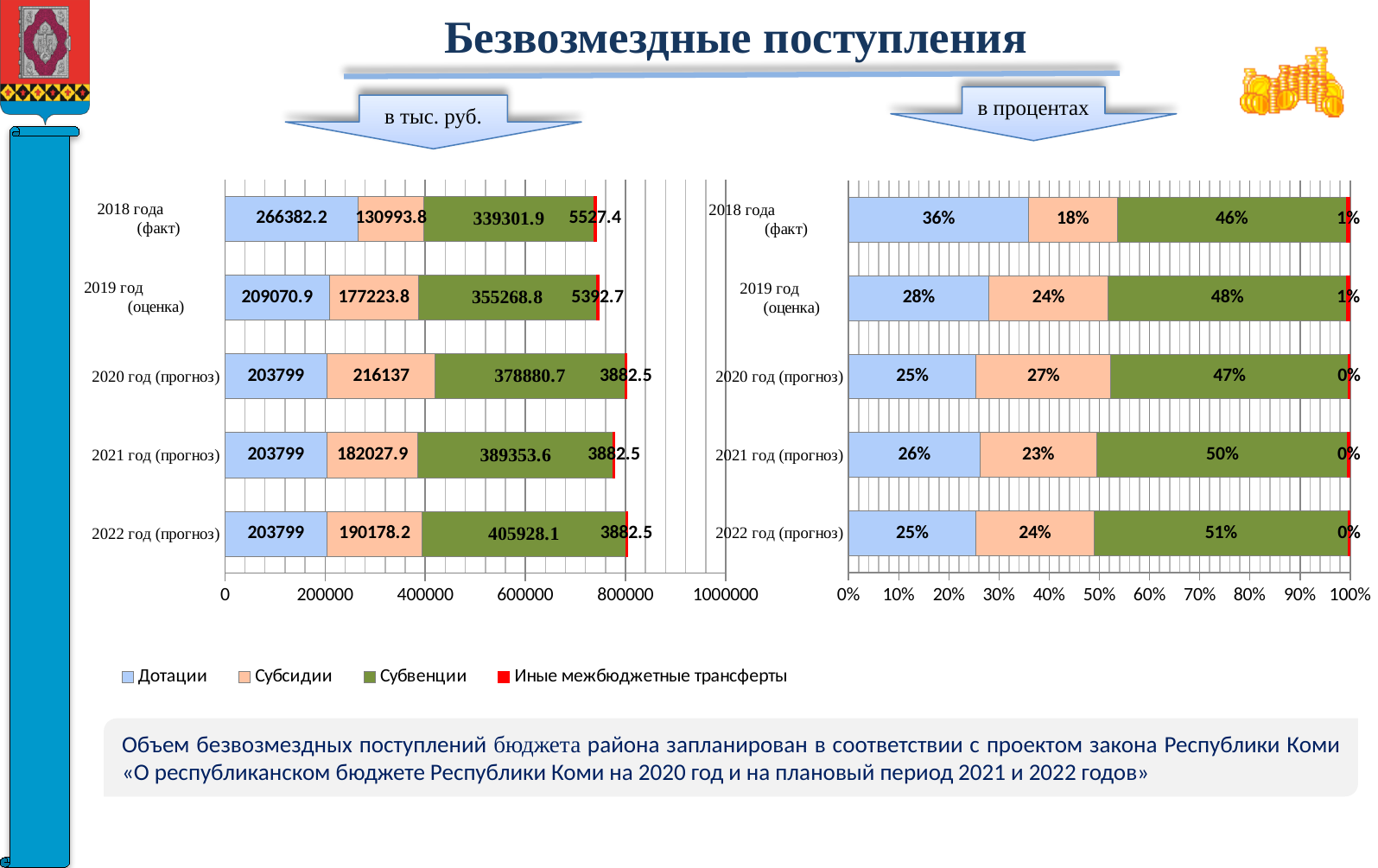
What kind of chart is the right chart (в процентах)? Stacked bar chart In the left chart (в тыс. руб.), what is the value of Субвенции for 2022 год (прогноз)? 405928.1 In the left chart (в тыс. руб.), is the total length of the 2018 года (факт) bar greater or less than 800000? less How many series does the legend list? 4 In the left chart (в тыс. руб.), do the values for Субвенции rise or fall from 2018 года (факт) to 2022 год (прогноз)? rise In the right chart (в процентах), what share do Дотации make up in 2018 года (факт)? 36% How many year categories are shown in the left chart (в тыс. руб.)? 5 In the left chart (в тыс. руб.), what is the difference between Субсидии in 2020 год (прогноз) and 2021 год (прогноз)? 34109.1 In the right chart (в процентах), which year has the lowest share for Субсидии? 2018 года (факт) In the left chart (в тыс. руб.), which year has the highest value for Субвенции? 2022 год (прогноз) In the left chart (в тыс. руб.), what is the total of the stacked bar for 2018 года (факт)? 742205.3 In the left chart (в тыс. руб.), which year has the larger value for Дотации: 2018 года (факт) or 2019 год (оценка)? 2018 года (факт)